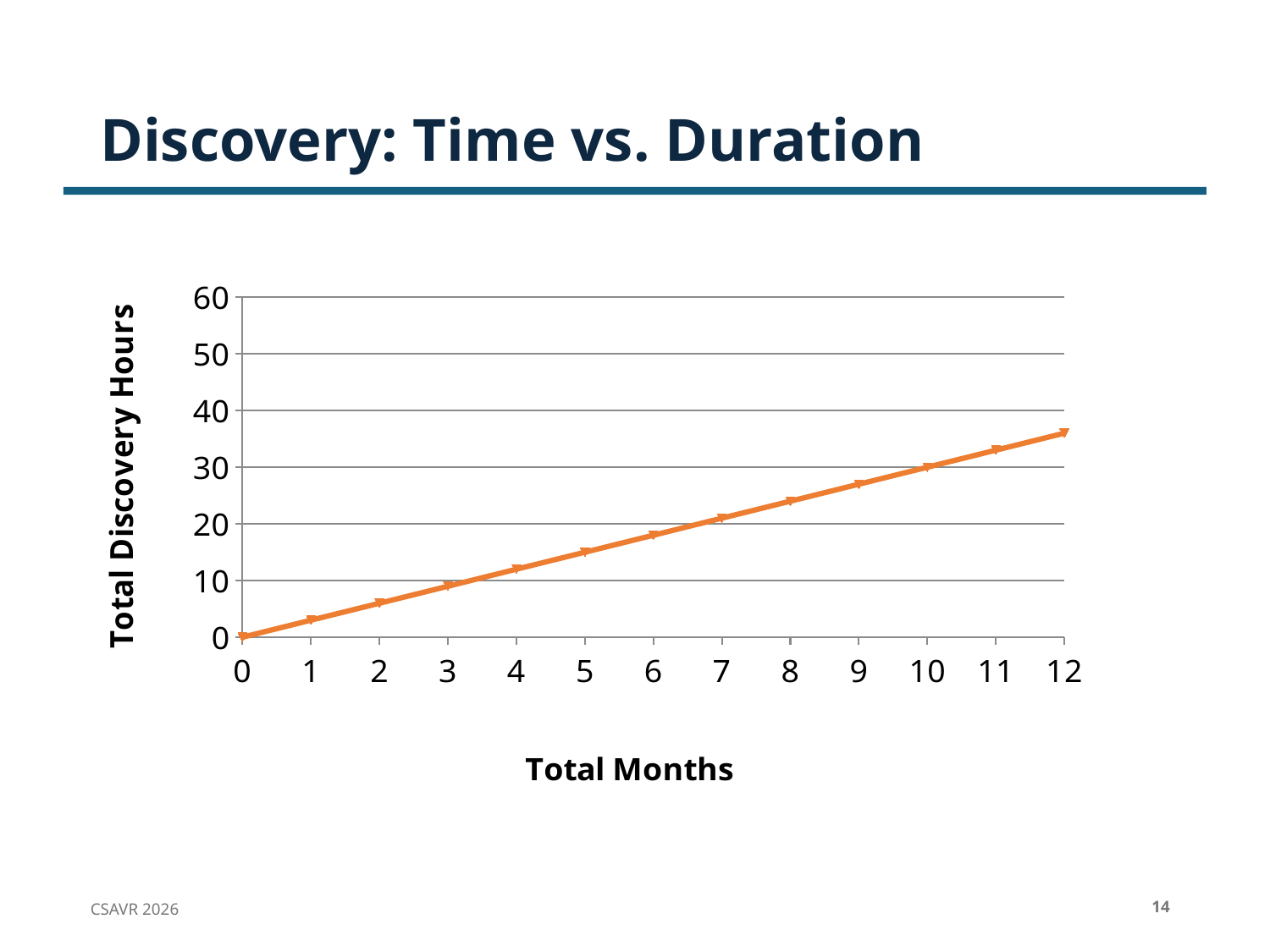
How many data points are plotted on the line? 13 Is the value for 12 Total Months greater or less than 30? greater Which has the higher Total Discovery Hours, 4 Total Months or 9 Total Months? 9 Total Months Is the value for 6 Total Months greater or less than 20? less What kind of chart is shown on the slide? line chart What is the value of Total Discovery Hours at 0 Total Months? 0 At which Total Months value are Total Discovery Hours highest? 12 What is the title of the vertical axis? Total Discovery Hours Is the value for 8 Total Months greater or less than 20? greater Do the Total Discovery Hours rise or fall as Total Months increases? rise What is the value of Total Discovery Hours at 10 Total Months? 30